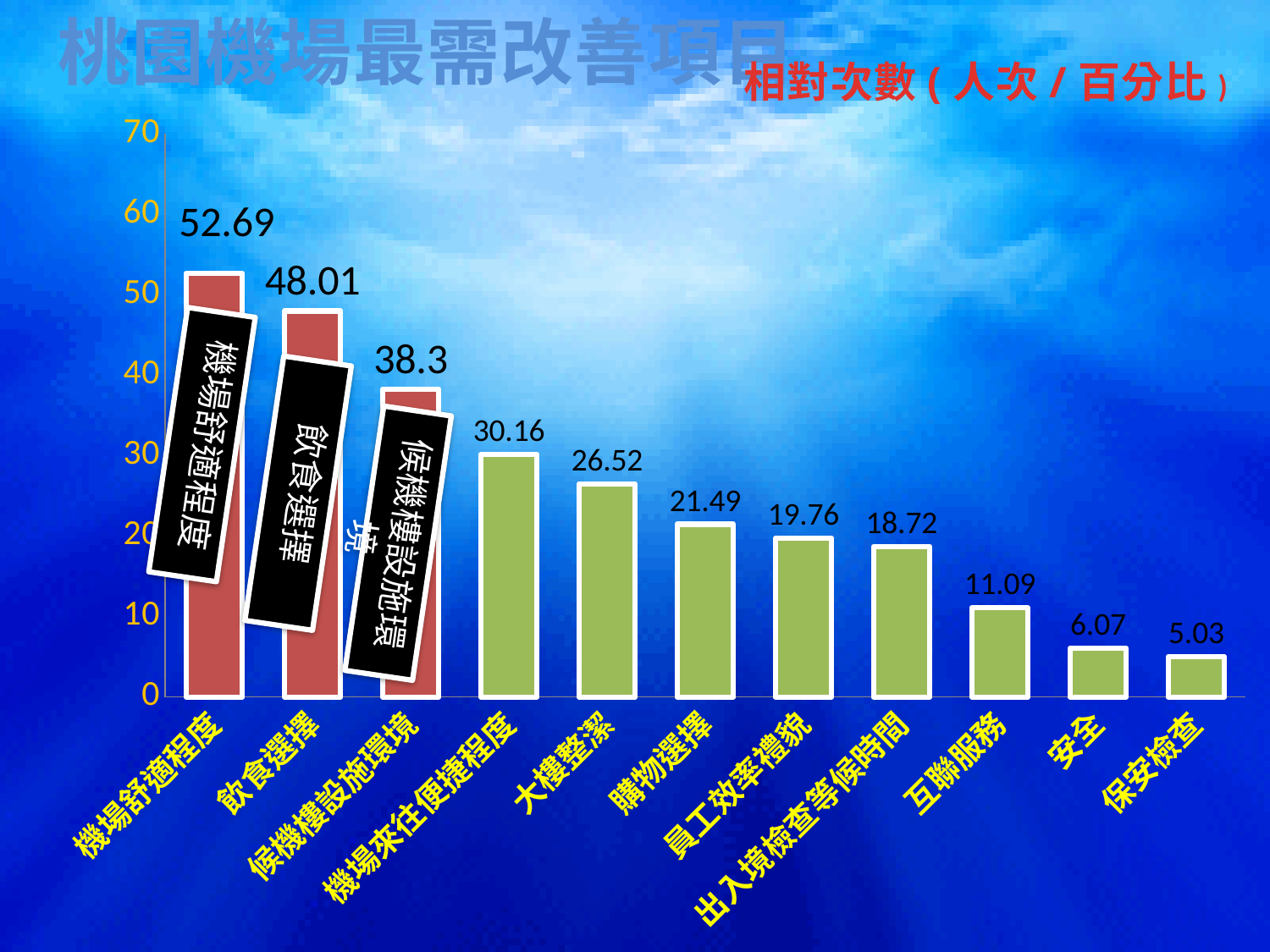
How many categories are shown in the chart? 11 Do the values rise or fall from left to right along the x axis? fall What is the value for 機場舒適程度? 52.69 Which category has the lowest value? 保安檢查 What kind of chart is shown on the slide? bar chart What is the value for 出入境檢查等候時間? 18.72 Is the value for 候機樓設施環境 greater or less than 40? less What is the difference between the values for 機場舒適程度 and 飲食選擇? 4.68 What is the value for 大樓整潔? 26.52 Which category has the highest value? 機場舒適程度 Which is larger, the value for 購物選擇 or the value for 員工效率禮貌? 購物選擇 What is the difference between the values for 互聯服務 and 安全? 5.02